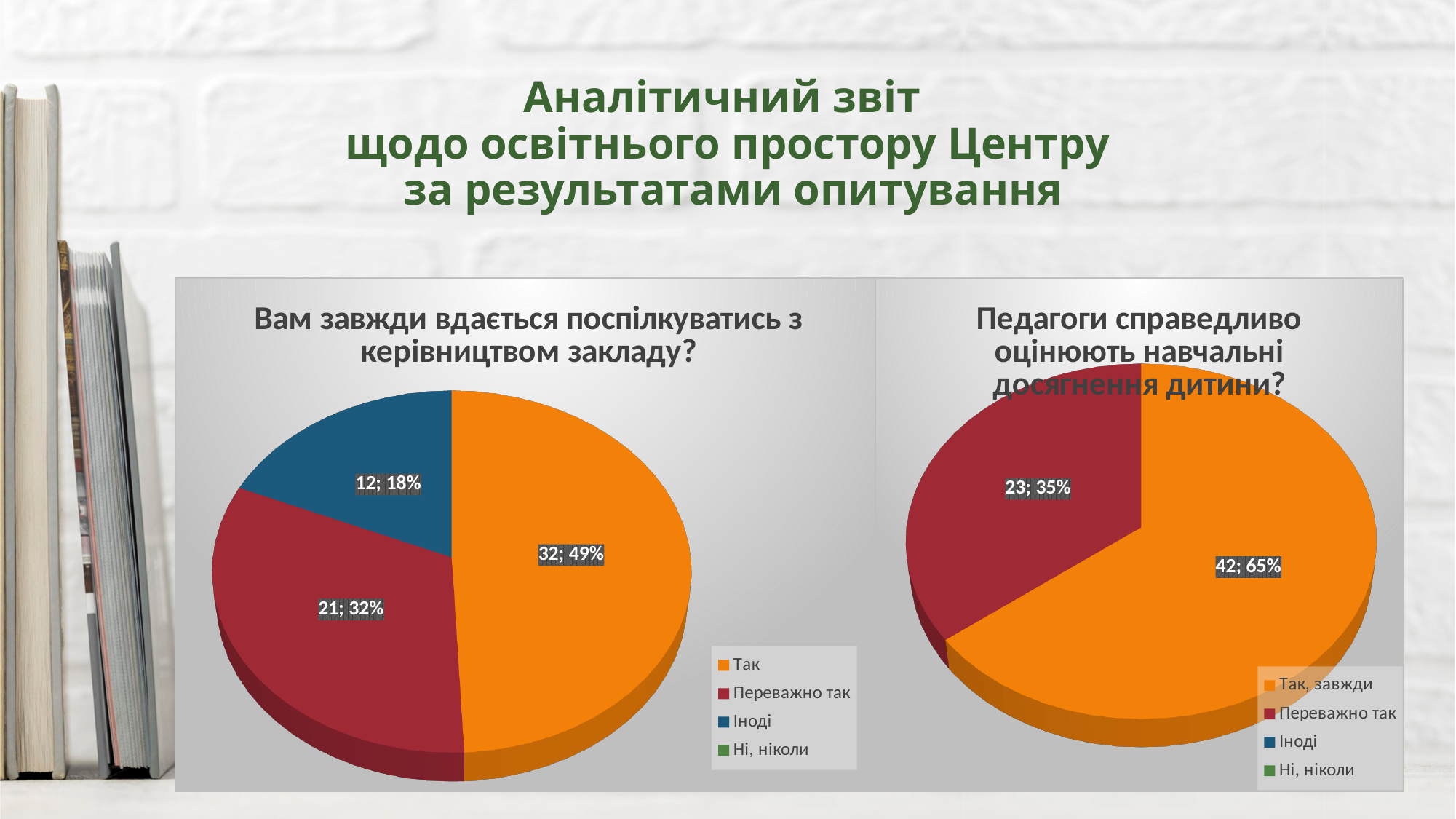
In the left chart ("Вам завжди вдається поспілкуватись з керівництвом закладу?"), which category has the largest slice? Так In the right chart ("Педагоги справедливо оцінюють навчальні досягнення дитини?"), what count is shown for "Так, завжди"? 42 In the left chart ("Вам завжди вдається поспілкуватись з керівництвом закладу?"), what share of the pie is "Іноді"? 18% How many entries does the legend of the left chart list? 4 In the left chart ("Вам завжди вдається поспілкуватись з керівництвом закладу?"), what is the difference between the counts for "Так" and "Переважно так"? 11 In the left chart ("Вам завжди вдається поспілкуватись з керівництвом закладу?"), what count is shown for "Так"? 32 In the left chart ("Вам завжди вдається поспілкуватись з керівництвом закладу?"), which visible slice is the smallest? Іноді What type of chart is used on the right side of the slide? Pie chart In the right chart ("Педагоги справедливо оцінюють навчальні досягнення дитини?"), what share of the pie is "Переважно так"? 35% In the right chart ("Педагоги справедливо оцінюють навчальні досягнення дитини?"), which is larger, "Так, завжди" or "Переважно так"? Так, завжди In the left chart ("Вам завжди вдається поспілкуватись з керівництвом закладу?"), what share of the pie is "Переважно так"? 32% In the right chart ("Педагоги справедливо оцінюють навчальні досягнення дитини?"), what is the difference between the counts for "Так, завжди" and "Переважно так"? 19